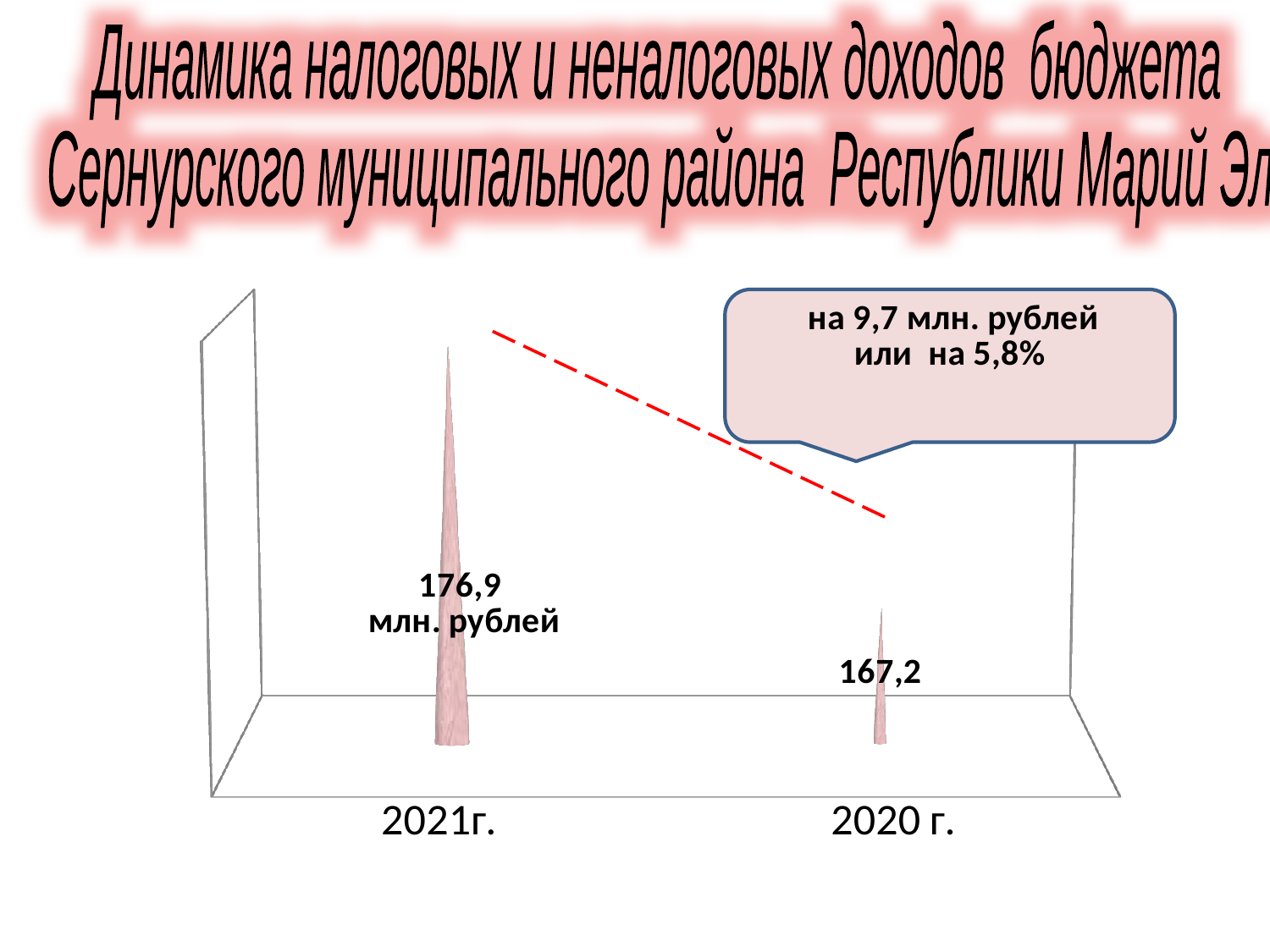
According to the callout, by what percentage did the value change? 5,8% Do the values rise or fall from left to right along the x axis? fall Which year has the lowest value? 2020 г. What is the difference between the values for 2021г. and 2020 г.? 9,7 Which is larger, the value for 2021г. or the value for 2020 г.? 2021г. What is the value for 2020 г.? 167,2 What kind of chart is shown on the slide? bar chart Which year has the highest value? 2021г. Which category is shown on the left of the x axis? 2021г. What is the value for 2021г.? 176,9 млн. рублей How many categories are shown on the x axis? 2